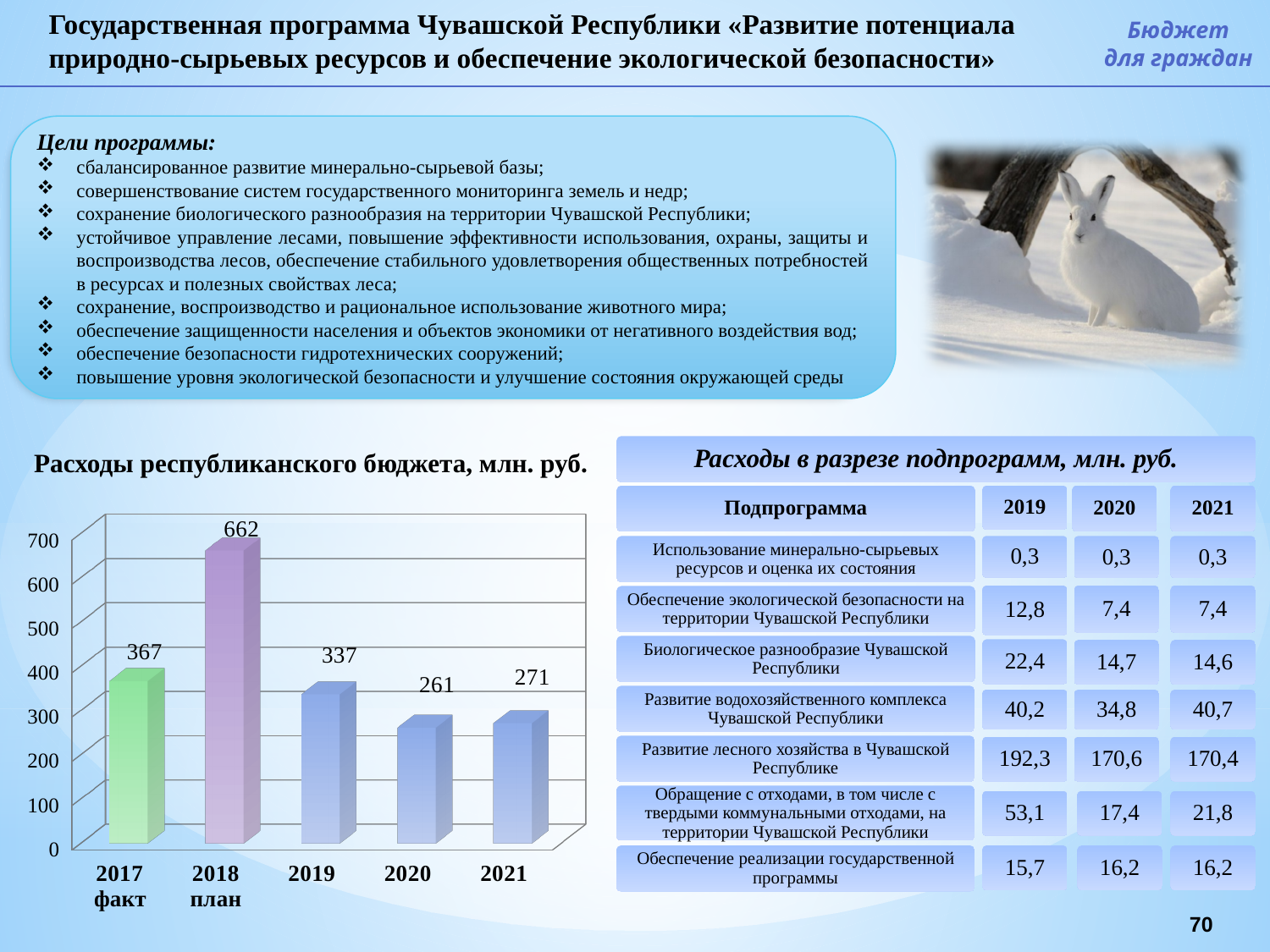
What is the value for 2020 in the chart 'Расходы республиканского бюджета, млн. руб.'? 261 In the chart 'Расходы республиканского бюджета, млн. руб.', what is the difference between the values for 2021 and 2020? 10 How many bars are shown in the chart 'Расходы республиканского бюджета, млн. руб.'? 5 In the chart 'Расходы республиканского бюджета, млн. руб.', which is larger: the value for 2017 факт or the value for 2019? 2017 факт Which year has the lowest value in the chart 'Расходы республиканского бюджета, млн. руб.'? 2020 What kind of chart is 'Расходы республиканского бюджета, млн. руб.'? bar chart In the chart 'Расходы республиканского бюджета, млн. руб.', do the values rise or fall from 2018 план to 2020? fall What is the value for 2017 факт in the chart 'Расходы республиканского бюджета, млн. руб.'? 367 In the chart 'Расходы республиканского бюджета, млн. руб.', is the value for 2019 greater or less than 300? greater In the chart 'Расходы республиканского бюджета, млн. руб.', what is the difference between the values for 2018 план and 2019? 325 What is the value for 2018 план in the chart 'Расходы республиканского бюджета, млн. руб.'? 662 Which year has the highest value in the chart 'Расходы республиканского бюджета, млн. руб.'? 2018 план